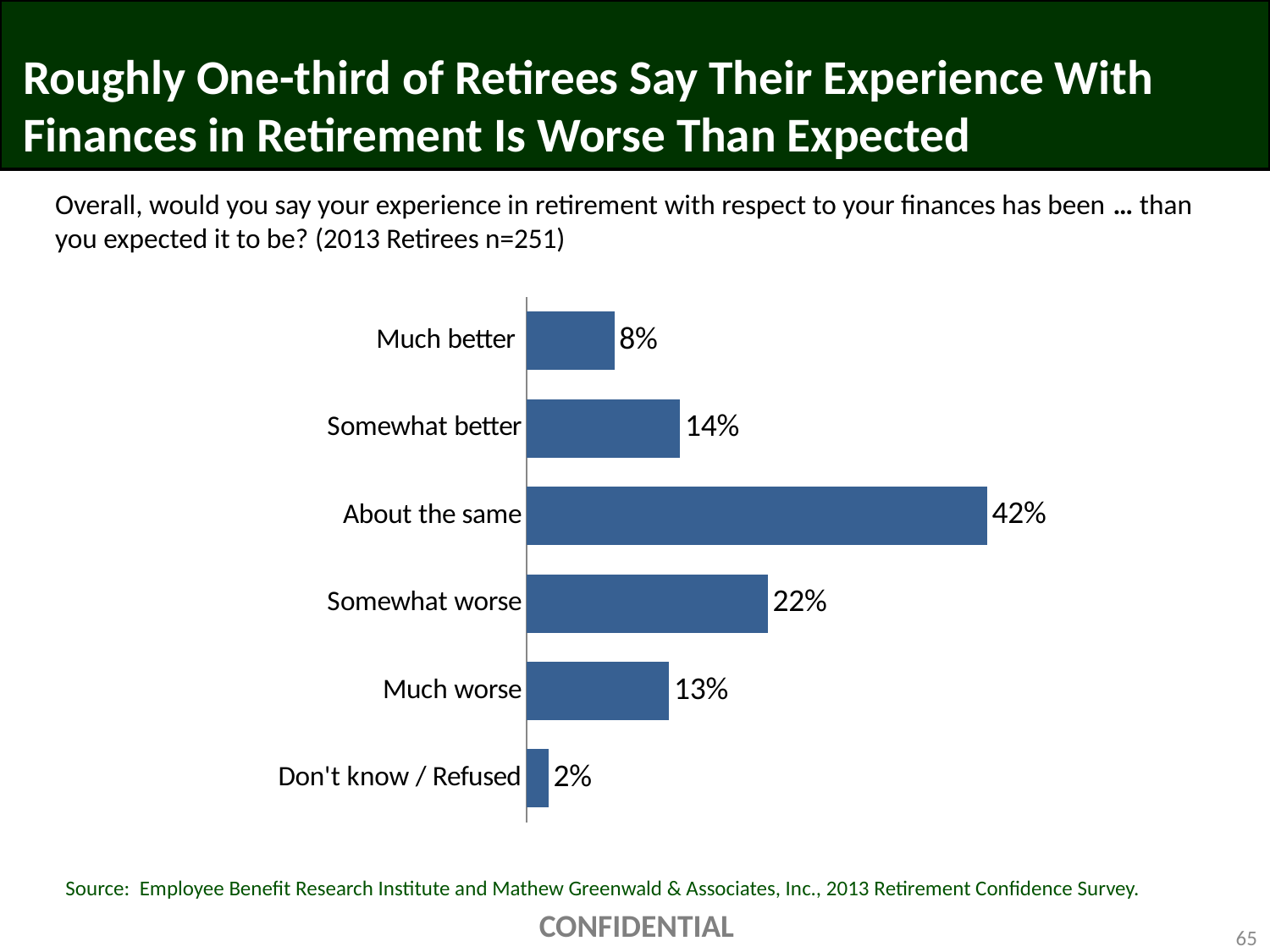
Which is larger, the percentage for 'Somewhat better' or for 'Much worse'? Somewhat better What percentage of retirees answered 'Much better'? 8% How many response categories are shown in the chart? 6 What is the difference in percentage points between 'Somewhat worse' and 'Much worse'? 9 What is the difference in percentage points between 'About the same' and 'Somewhat better'? 28 What percentage of retirees said their experience was somewhat worse than expected? 22% What type of chart is shown on the slide? Bar chart Which response category has the lowest percentage? Don't know / Refused Which response category has the highest percentage? About the same What is the sample size of 2013 retirees stated in the question text above the chart? n=251 What percentage of retirees answered 'Don't know / Refused'? 2% What percentage of retirees said their experience with finances in retirement was about the same as expected? 42%